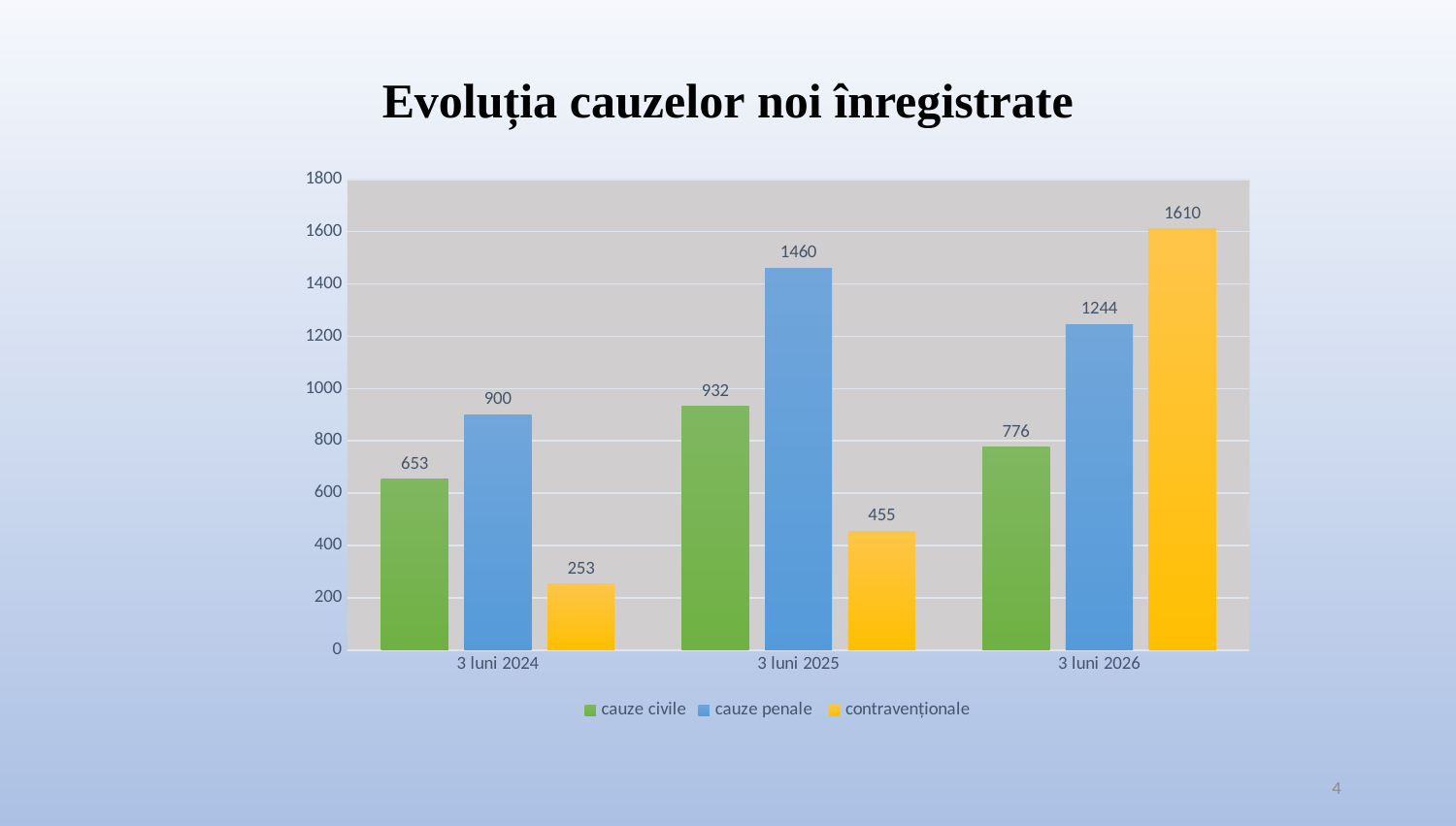
What is the difference between cauze penale in 3 luni 2025 and 3 luni 2026? 216 Which is larger: cauze civile in 3 luni 2025 or cauze civile in 3 luni 2026? 3 luni 2025 Do the values for contravenționale rise or fall from 3 luni 2024 to 3 luni 2026? rise What is the value for contravenționale in 3 luni 2024? 253 How many series does the legend list? 3 What is the value for cauze civile in 3 luni 2026? 776 How many categories are shown on the x axis? 3 What kind of chart is shown on the slide? bar chart Is the value for contravenționale in 3 luni 2025 greater or less than 400? greater Which series has the lowest value in 3 luni 2024? contravenționale Which series has the highest value in 3 luni 2026? contravenționale What is the value for cauze penale in 3 luni 2025? 1460